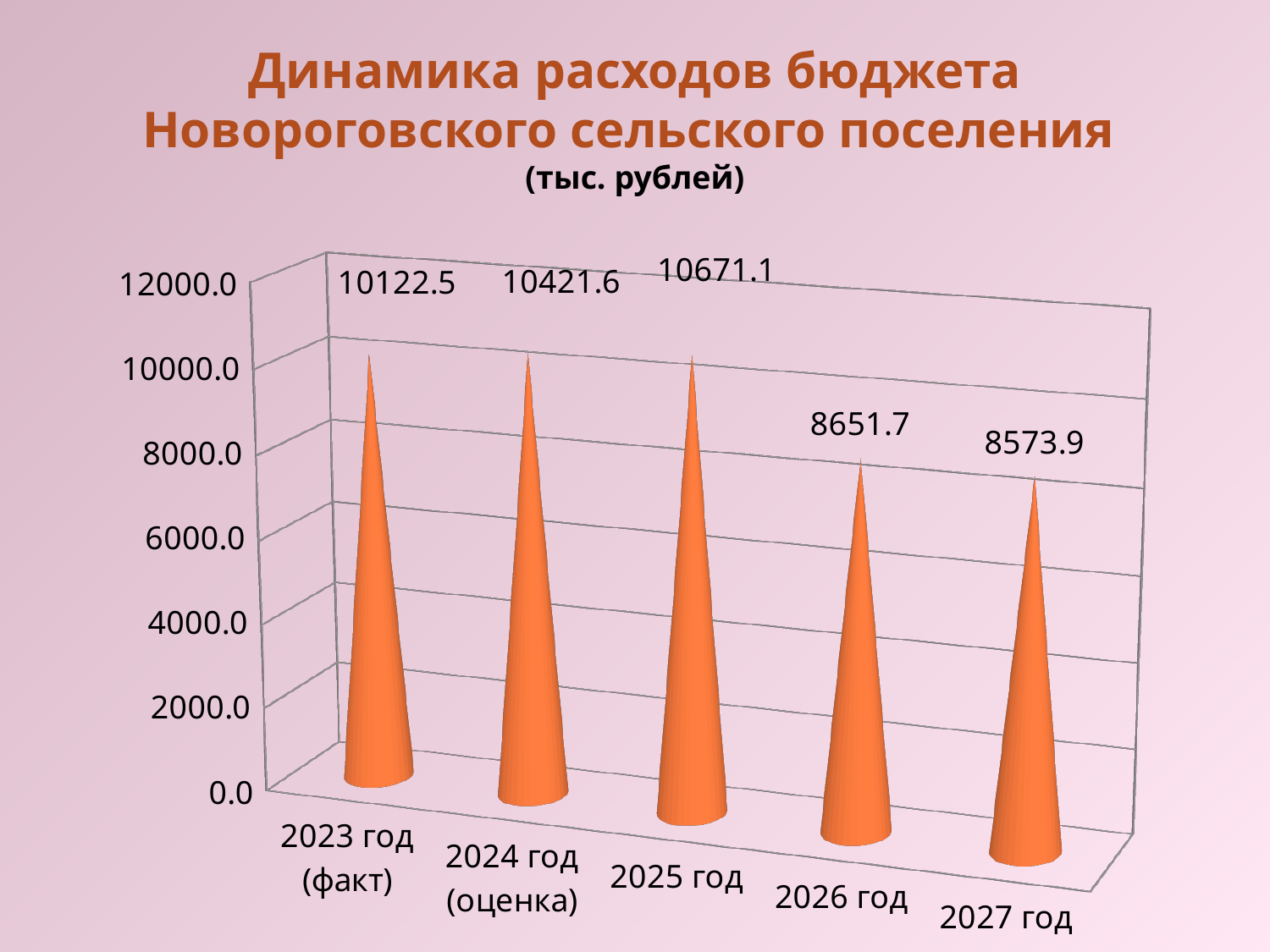
What is the value for 2023 год (факт)? 10122.5 Which is larger, the value for 2024 год (оценка) or the value for 2026 год? 2024 год (оценка) How many years are shown on the chart? 5 What is the value for 2027 год? 8573.9 What kind of chart is shown on the slide? bar chart Is the value for 2026 год greater or less than 10000.0? less Which year has the lowest value? 2027 год What is the difference between the values for 2025 год and 2023 год (факт)? 548.6 What unit is stated under the chart title? тыс. рублей What is the value for 2025 год? 10671.1 What is the difference between the values for 2026 год and 2027 год? 77.8 Which year has the highest value? 2025 год